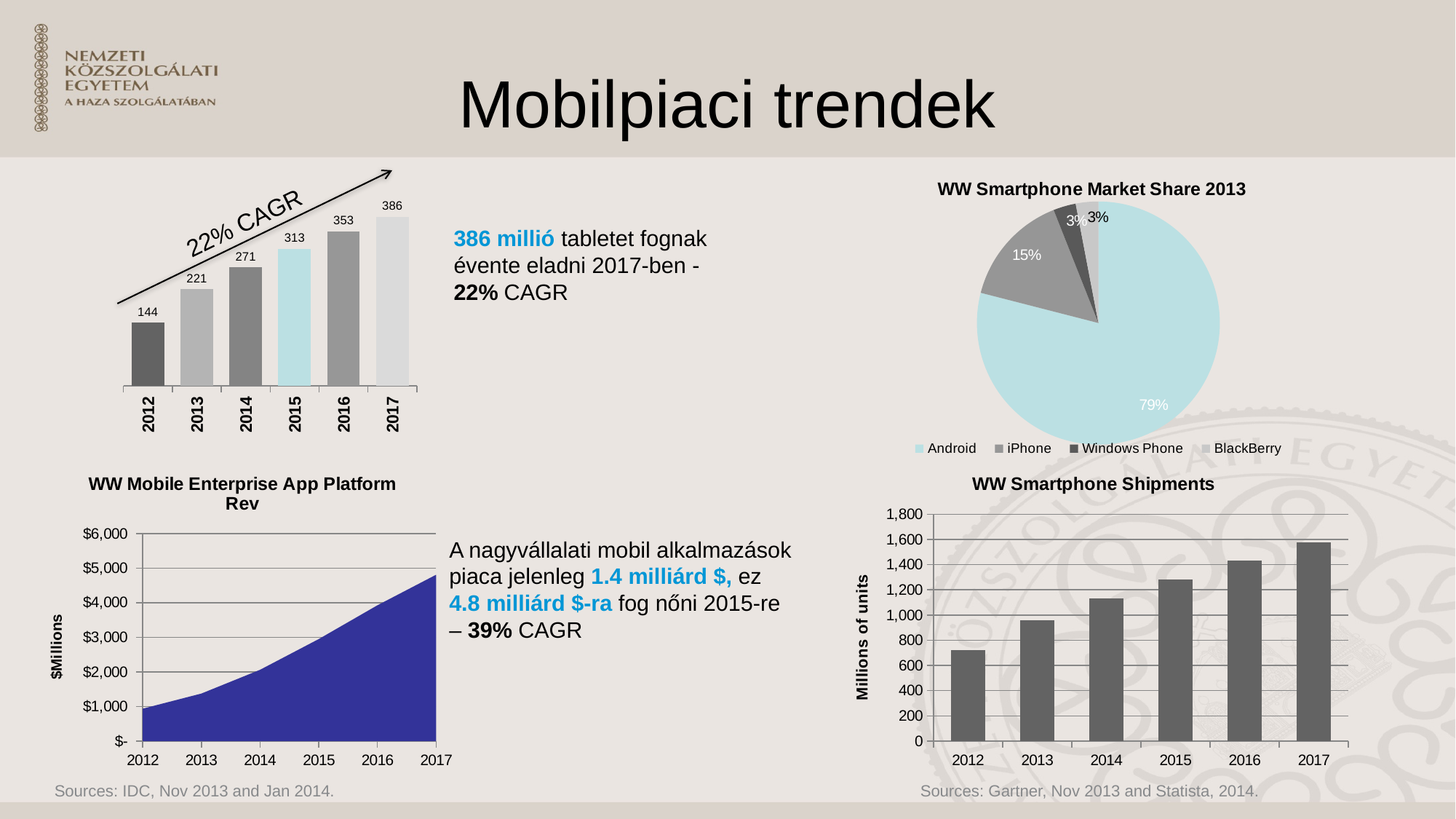
How many entries does the legend of the WW Smartphone Market Share 2013 chart list? 4 In the top-left bar chart of tablet sales, how many years are shown? 6 In the WW Smartphone Shipments chart, which year has the highest value? 2017 In the WW Smartphone Market Share 2013 pie chart, what share does Android have? 79% In the top-left bar chart of tablet sales, which year has the lowest value? 2012 In the top-left bar chart of tablet sales, what is the value for 2012? 144 In the top-left bar chart of tablet sales, what is the value for 2017? 386 What kind of chart is WW Mobile Enterprise App Platform Rev? area chart In the top-left bar chart of tablet sales, what is the difference between the 2016 and 2015 values? 40 In the WW Smartphone Market Share 2013 pie chart, what share does iPhone have? 15% In the WW Smartphone Shipments chart, is the value for 2012 greater or less than 800? less In the WW Mobile Enterprise App Platform Rev chart, do values rise or fall from 2012 to 2017? rise